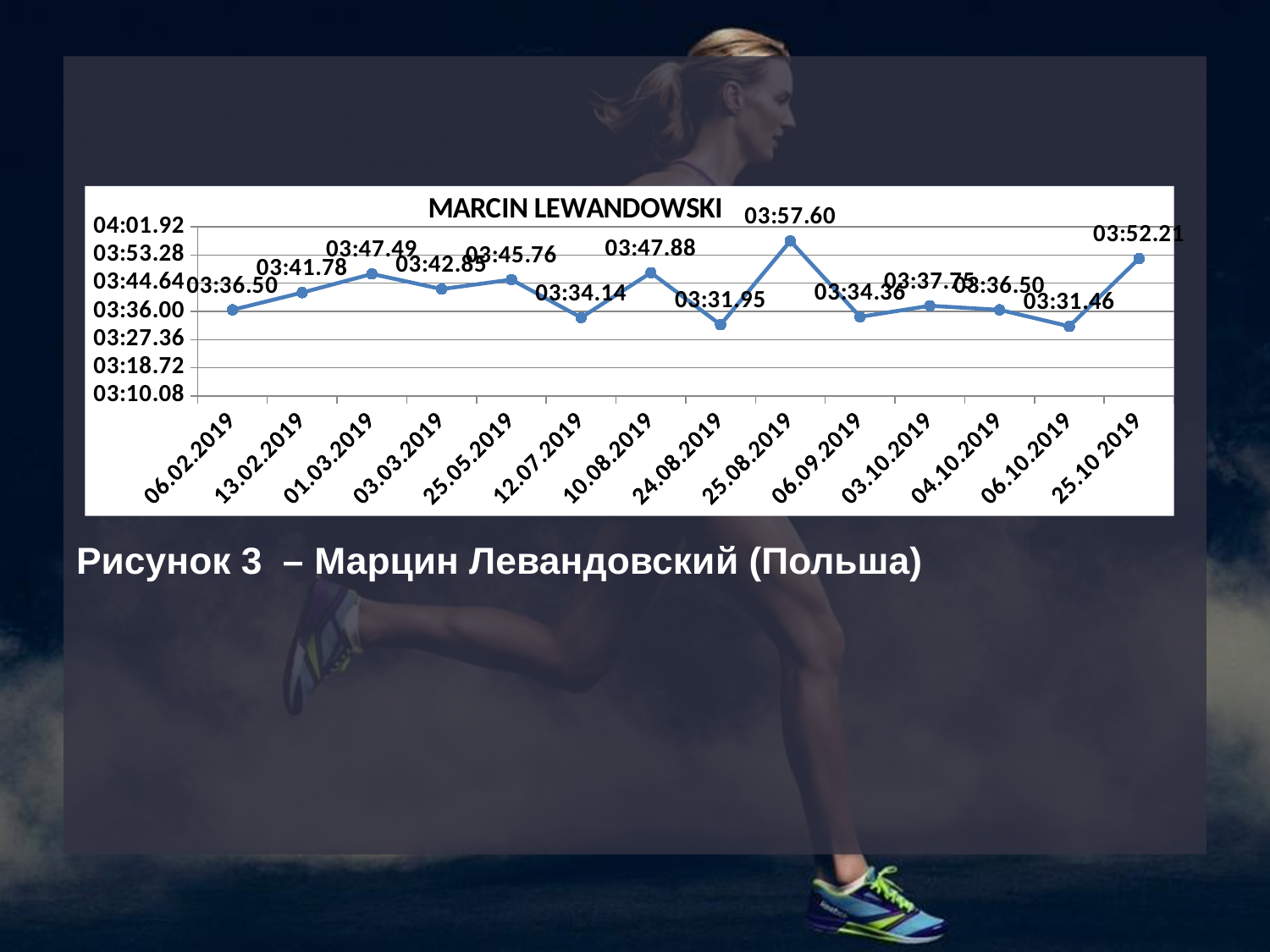
What is the value for 12.07.2019? 03:34.14 How many data points are plotted on the chart? 14 Which date has the lowest value? 06.10.2019 What is the value for 25.08.2019? 03:57.60 Which date has the highest value? 25.08.2019 Which is larger, the value for 01.03.2019 or the value for 03.03.2019? 01.03.2019 What is the title of the chart? MARCIN LEWANDOWSKI What kind of chart is shown on the slide? Line chart Which is larger, the value for 24.08.2019 or the value for 10.08.2019? 10.08.2019 What is the value for 03.10.2019? 03:37.75 What is the value for 06.02.2019? 03:36.50 What is the value for 25.10.2019? 03:52.21